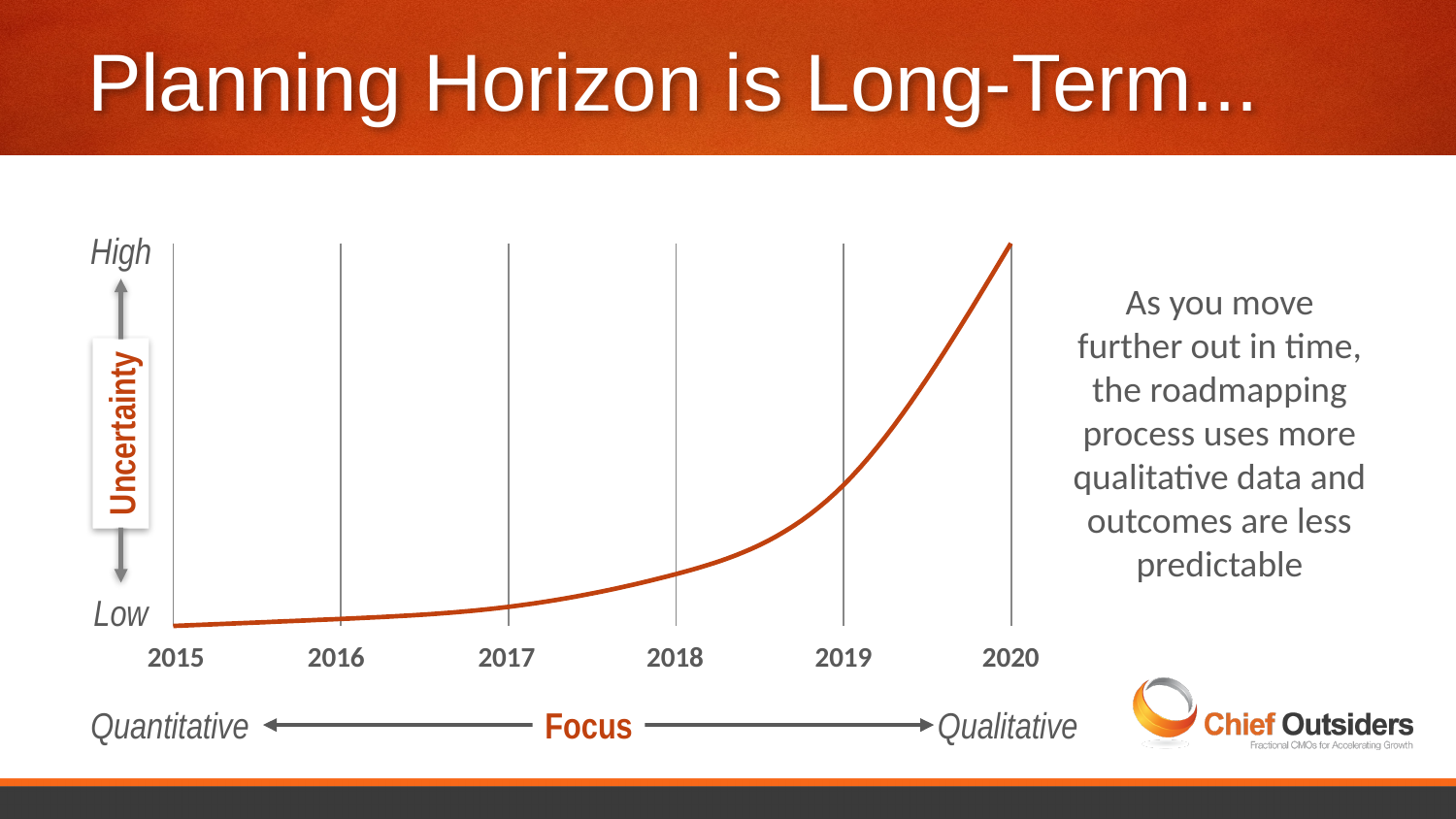
Is the uncertainty higher in 2019 or in 2017? 2019 Does the uncertainty line rise or fall as the years move from 2015 to 2020? rise What are the two end labels of the Focus arrow below the chart? Quantitative and Qualitative Is the uncertainty higher in 2016 or in 2020? 2020 Which year on the x axis has the highest uncertainty on the curve? 2020 What kind of chart is shown on the slide? line chart What is the last year shown on the x axis? 2020 Which year on the x axis has the lowest uncertainty on the curve? 2015 What quantity does the vertical axis of the chart represent? Uncertainty How many years are labelled along the x axis of the chart? 6 What is the first year shown on the x axis? 2015